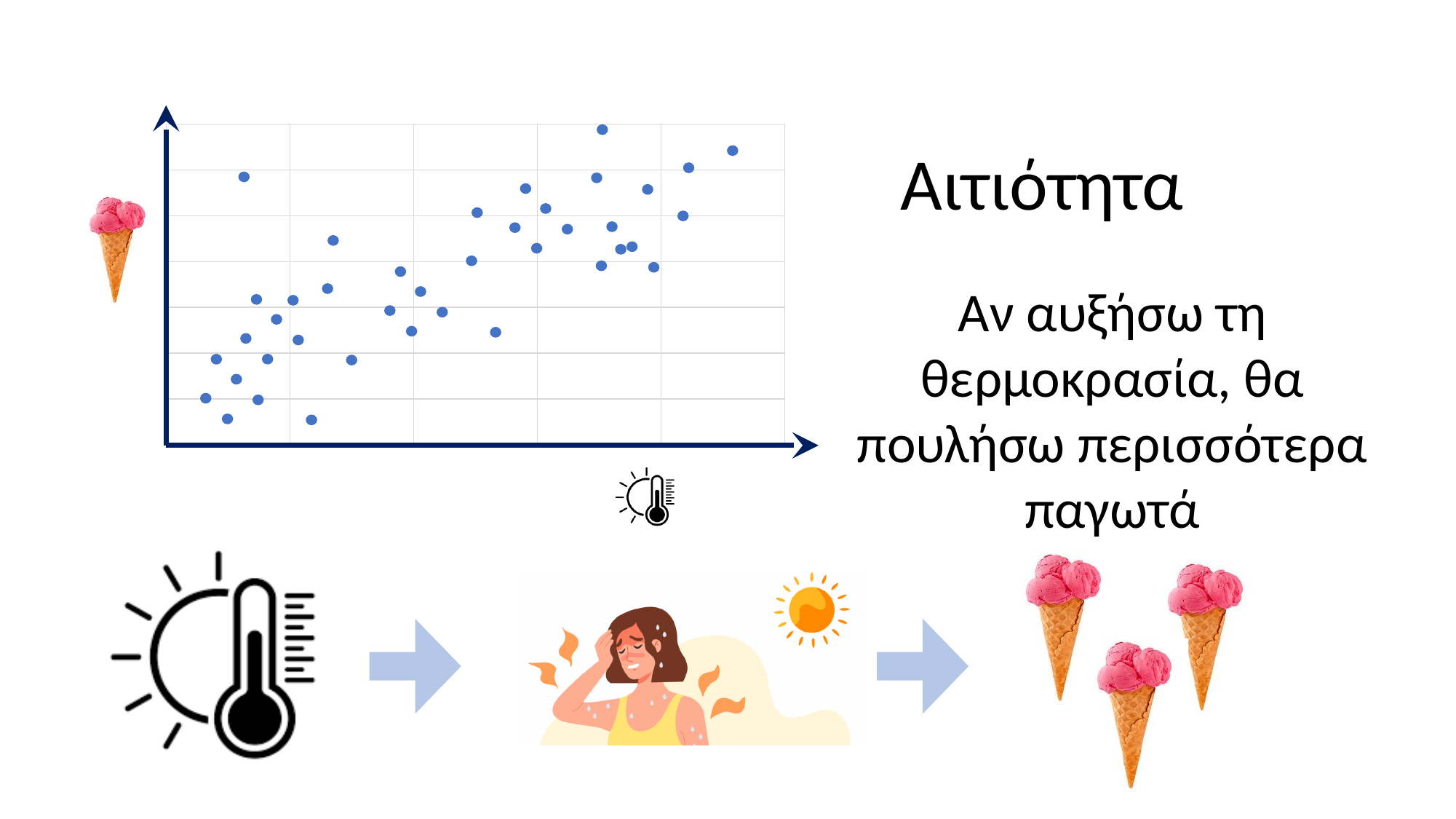
Which icon is placed next to the vertical axis of the chart? an ice cream cone What kind of chart is shown on the slide? scatter chart What colour are the plotted points in the scatter chart? blue Do the plotted values generally rise or fall as you move from left to right along the x axis? rise